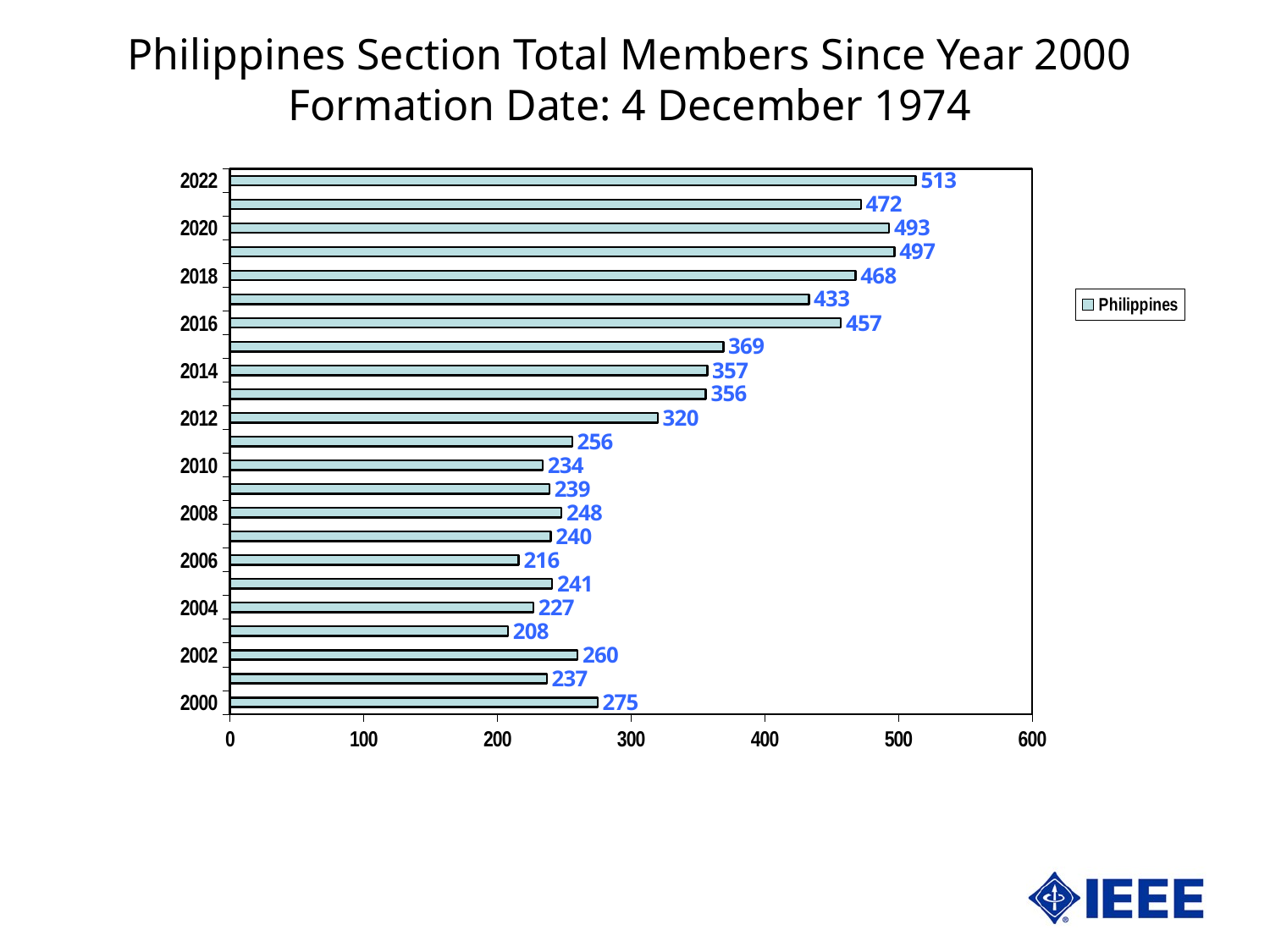
What is the value for 2022? 513 Which year has the highest value? 2022 What is the value for 2000? 275 How many series does the legend list? 1 What series name is shown in the legend? Philippines Which is larger, the value for 2016 or the value for 2018? 2018 What is the difference between the values for 2022 and 2000? 238 What kind of chart is shown on the slide? bar chart What is the value for 2012? 320 Is the value for 2019 greater or less than 400? greater How many bars are plotted in the chart? 23 Which year has the lowest value? 2003